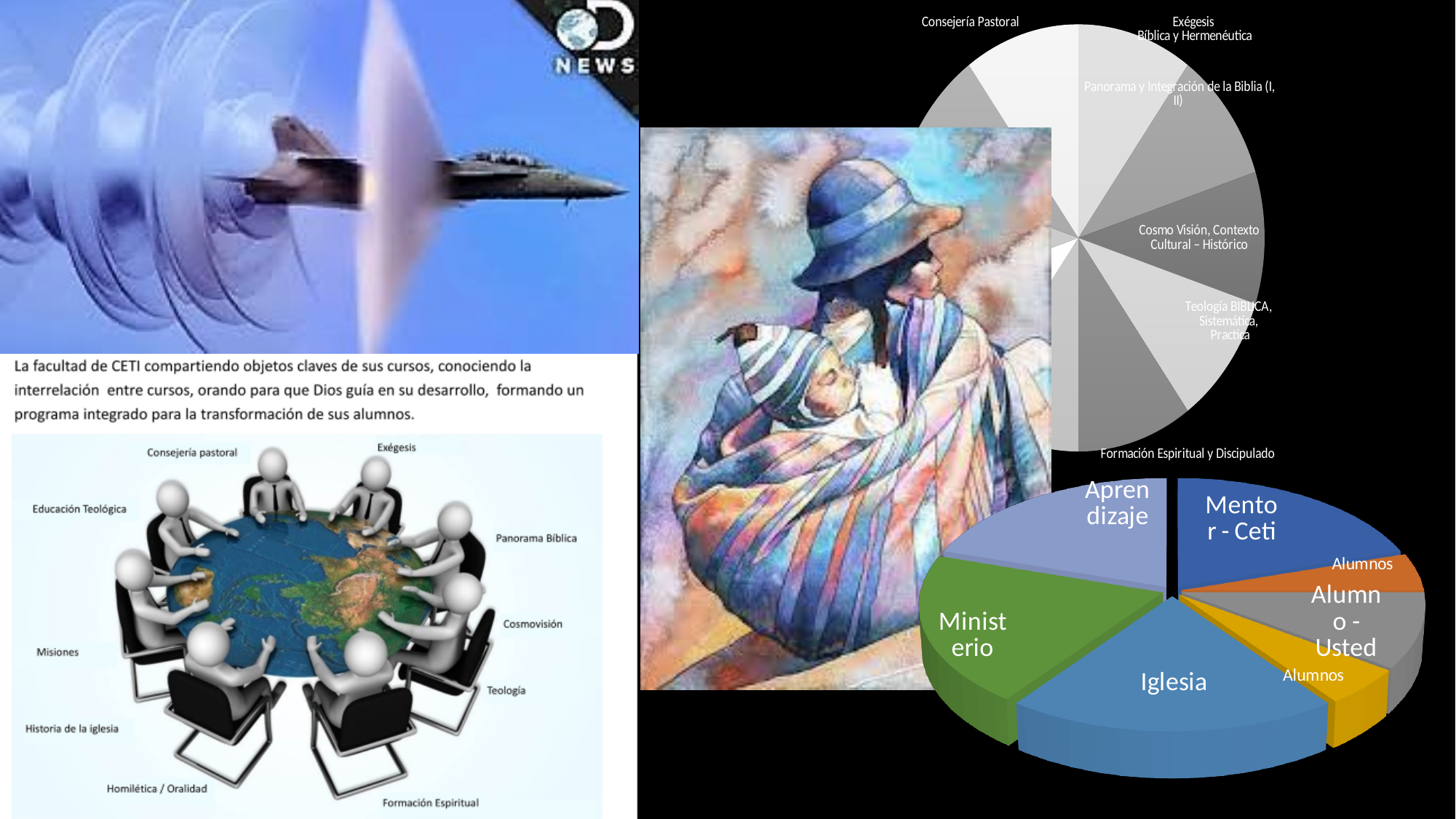
What kind of chart is the chart at the bottom right of the slide? pie chart In the bottom-right pie chart, what colour is the Mentor - Ceti slice? blue In the bottom-right pie chart, how many slices are shown? 7 What kind of chart is the grayscale chart at the top right of the slide? pie chart In the top-right grayscale pie chart, which slice is labelled at the bottom of the chart? Formación Espiritual y Discipulado In the top-right grayscale pie chart, which slice label appears at the top left of the chart? Consejería Pastoral In the bottom-right pie chart, what colour is the Ministerio slice? green In the bottom-right pie chart, which slice is larger, Ministerio or the orange Alumnos slice? Ministerio